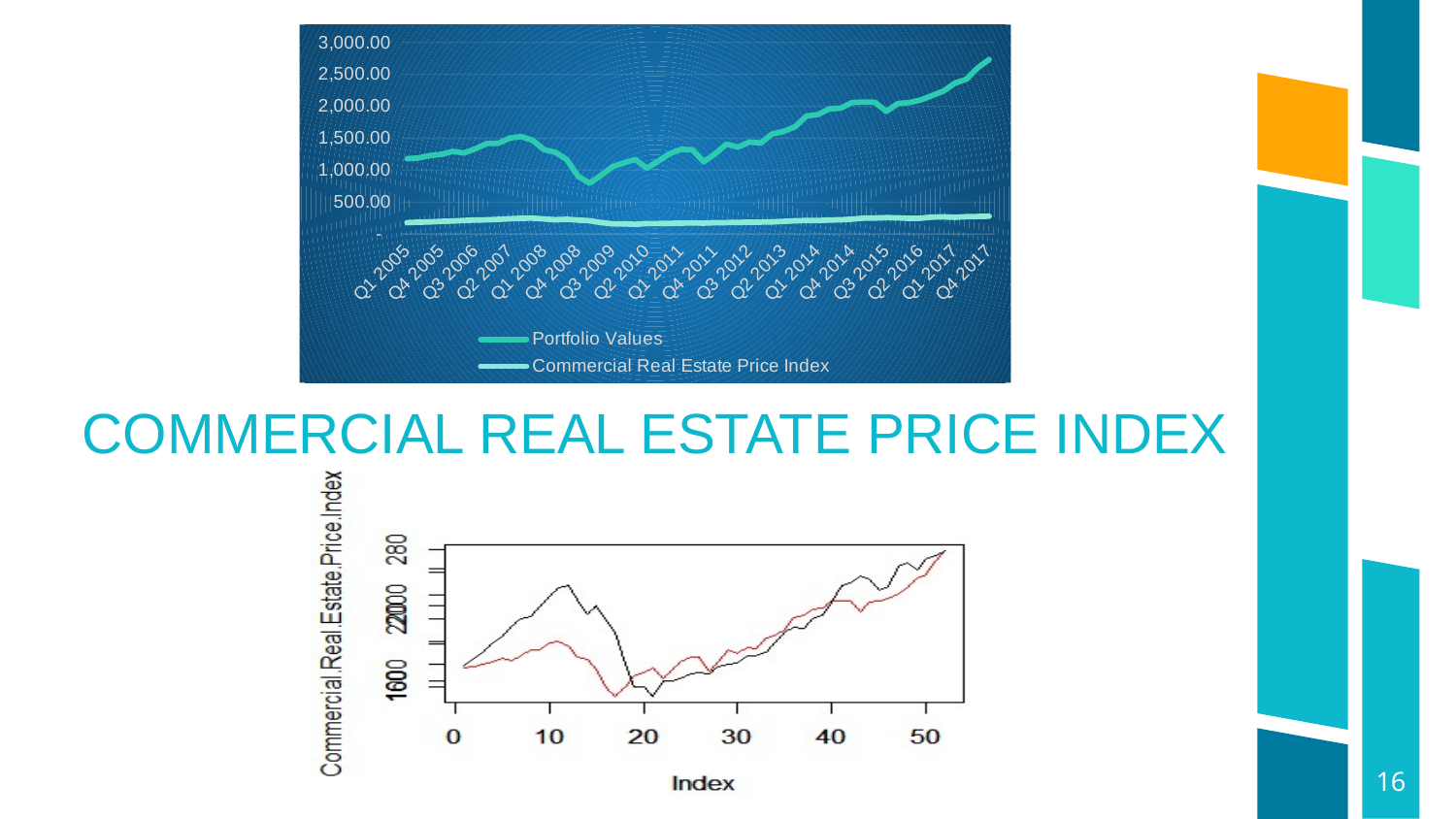
In the top chart, what is the first category label on the x axis? Q1 2005 In the top chart, does the Portfolio Values series overall rise or fall from Q1 2005 to Q4 2017? rise What kind of chart is the bottom chart on the slide? line chart How many series does the legend of the top chart list? 2 In the top chart, which series is plotted higher on the axis throughout, Portfolio Values or Commercial Real Estate Price Index? Portfolio Values In the top chart, what is the highest value shown on the y axis? 3,000.00 In the top chart, is the Portfolio Values value at Q4 2017 greater or less than 2,500.00? greater In the bottom chart, how many lines are plotted? 2 In the top chart, is the Commercial Real Estate Price Index value at Q4 2017 greater or less than 500.00? less What kind of chart is the top chart on the slide? line chart